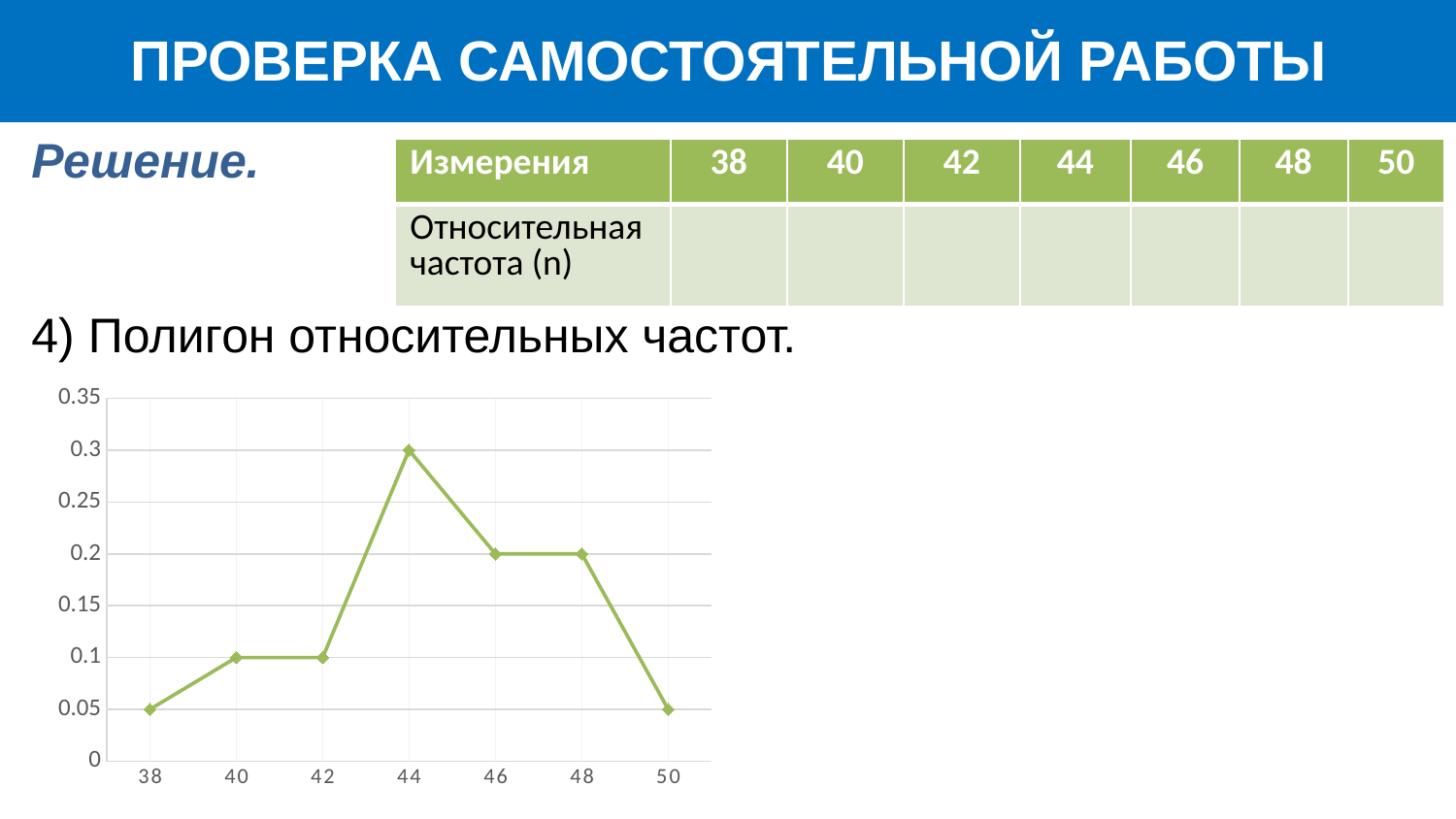
What is the value for 44 on the line chart? 0.3 What is the value for 46 on the line chart? 0.2 Is the value for 48 on the line chart greater or less than 0.15? greater What is the value for 38 on the line chart? 0.05 What is the difference between the values for 44 and 42 on the line chart? 0.2 Which of the two values is larger on the line chart: 44 or 46? 44 Does the line rise or fall between 48 and 50 on the line chart? fall Which category has the highest value on the line chart? 44 How many data points are plotted on the line chart? 7 What kind of chart is shown on the slide? line chart What is the value for 40 on the line chart? 0.1 What is the highest value shown on the vertical axis of the line chart? 0.35